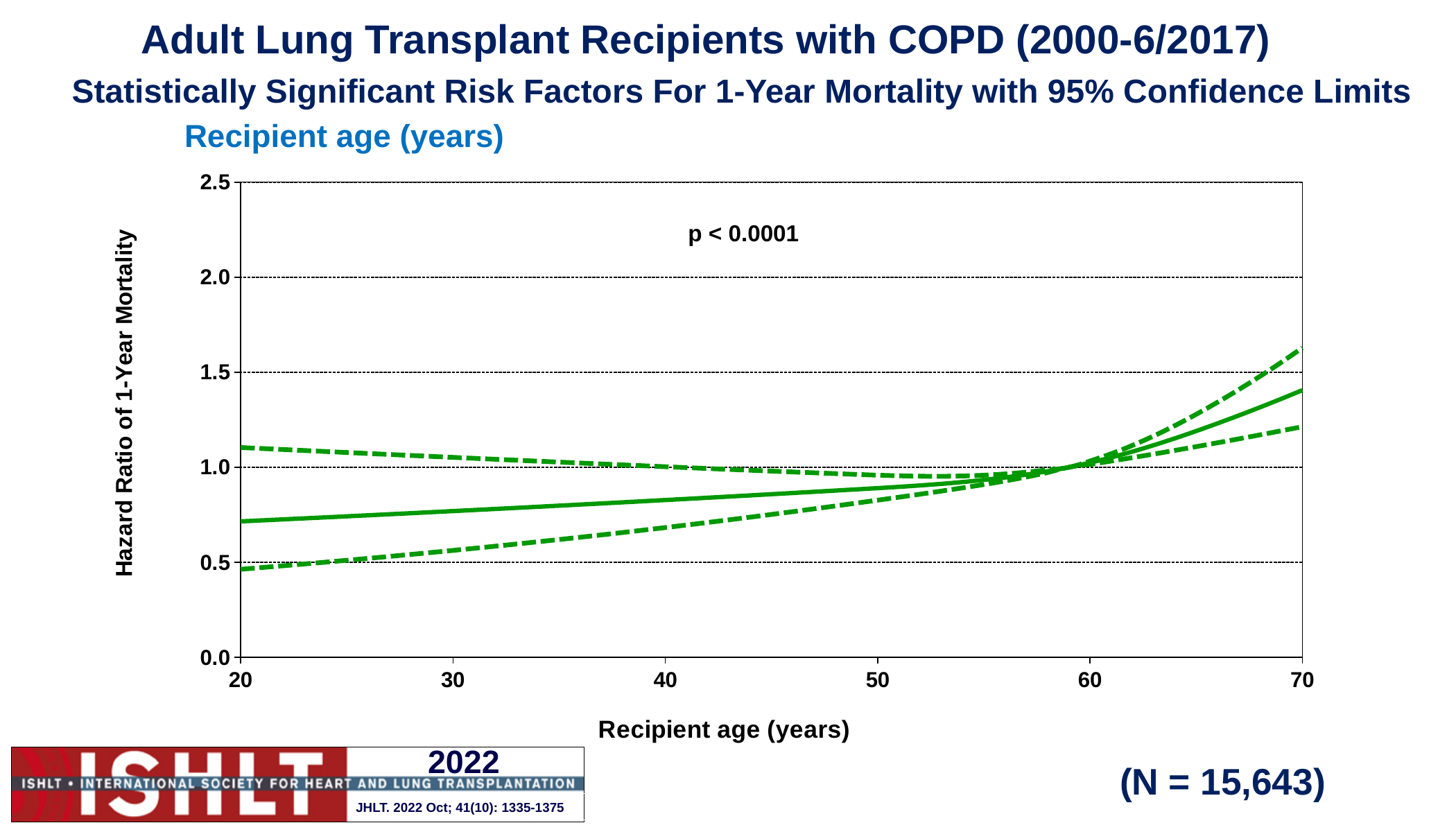
How many lines are plotted on the chart? 3 Does the solid hazard ratio line rise or fall as recipient age increases from 20 to 70 years? rise Is the lower dashed confidence limit at recipient age 20 greater or less than 0.5? less Is the upper dashed confidence limit at recipient age 70 greater or less than 1.5? greater Is the solid hazard ratio line at recipient age 20 greater or less than 1.0? less What kind of chart is shown on the slide? line chart What is the p-value printed on the chart? p < 0.0001 What is the title of the chart? Recipient age (years) What is the label of the y axis? Hazard Ratio of 1-Year Mortality